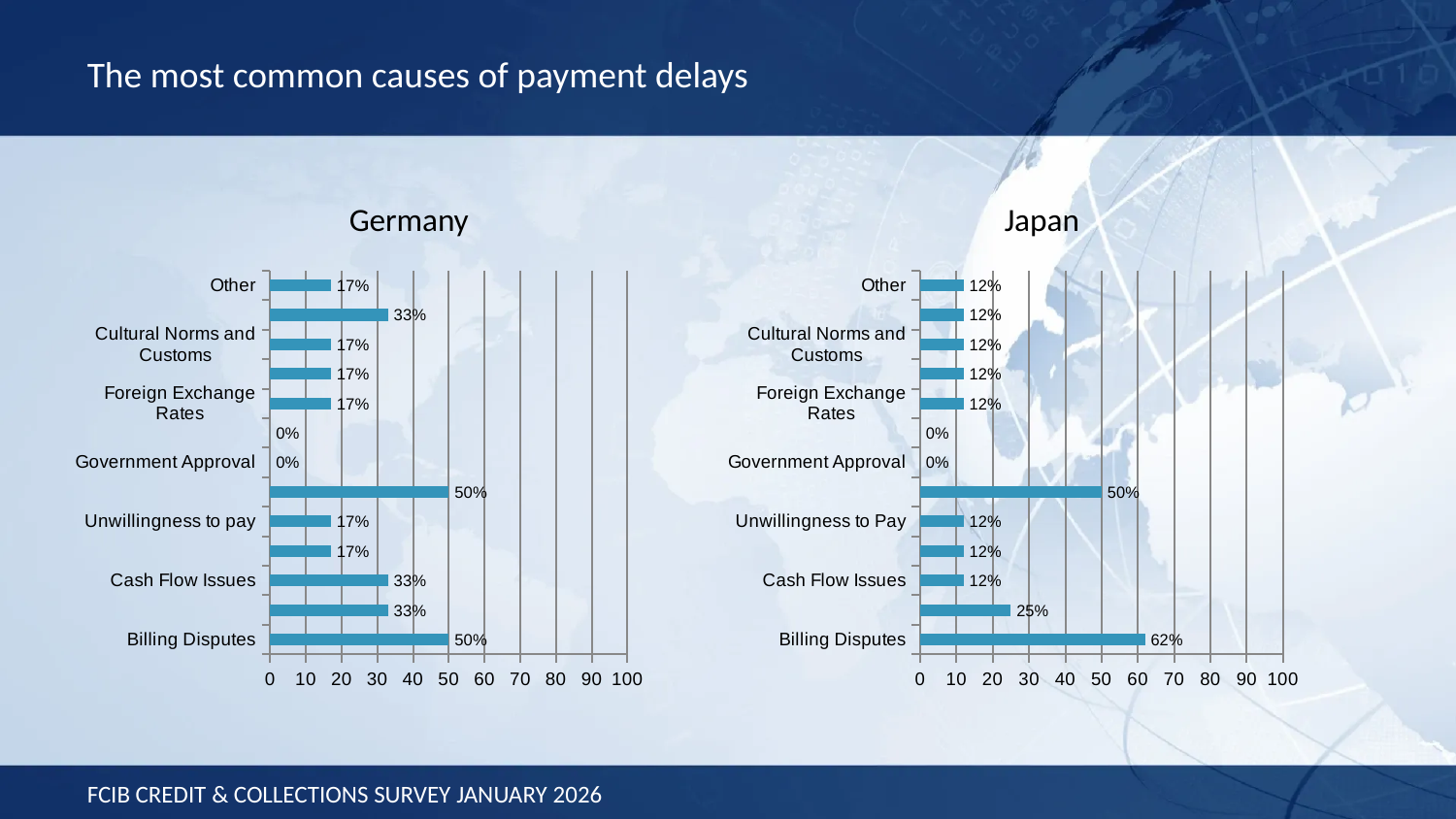
In the Germany chart, what is the difference between Billing Disputes and Cash Flow Issues? 17% In the Japan chart, what is the difference between Billing Disputes and Cash Flow Issues? 50% What type of chart is the Germany chart? Bar chart In the Japan chart, what is the value for Unwillingness to Pay? 12% What is the title of the chart on the right side of the slide? Japan Which is larger: Billing Disputes in the Germany chart or Billing Disputes in the Japan chart? Japan In the Japan chart, what is the value for Billing Disputes? 62% In the Germany chart, what is the value for Cash Flow Issues? 33% In the Japan chart, what is the value for Government Approval? 0% In the Germany chart, which labeled category has the highest value? Billing Disputes In the Germany chart, what is the value for Billing Disputes? 50% In the Japan chart, which labeled category has the lowest value? Government Approval